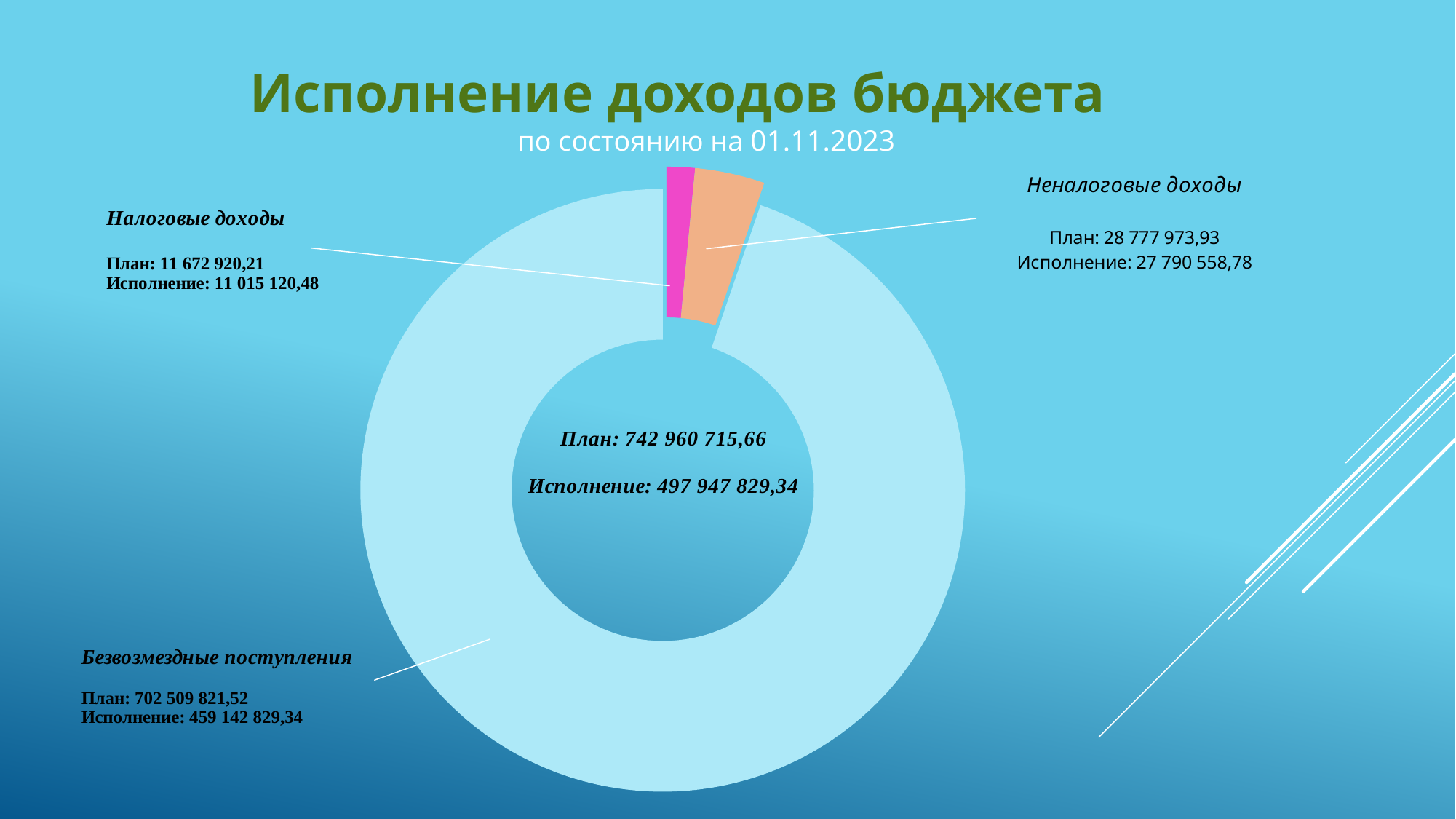
What is the execution (Исполнение) value for Налоговые доходы? 11 015 120,48 What is the total plan value shown in the centre of the chart? 742 960 715,66 What is the plan value for Налоговые доходы? 11 672 920,21 What is the difference between the plan and execution values for Налоговые доходы? 657 799,73 What is the plan value for Неналоговые доходы? 28 777 973,93 What is the total execution (Исполнение) value shown in the centre of the chart? 497 947 829,34 What is the execution (Исполнение) value for Безвозмездные поступления? 459 142 829,34 What type of chart is shown on the slide? doughnut chart Which is larger: the execution value for Неналоговые доходы or for Налоговые доходы? Неналоговые доходы Which category has the smallest execution value? Налоговые доходы How many categories does the chart show? 3 Which category has the largest plan value? Безвозмездные поступления